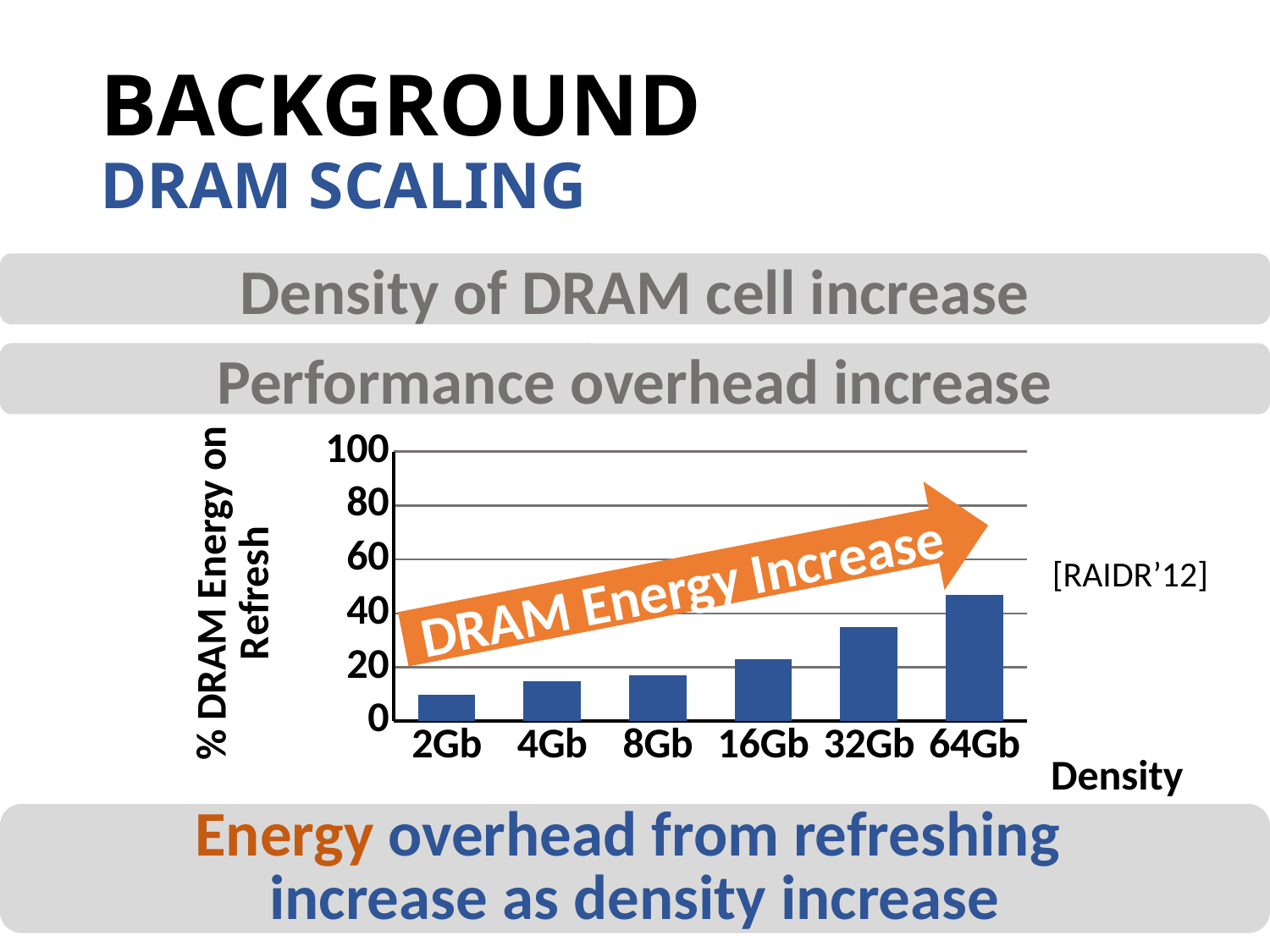
Is the value for 32Gb greater or less than 40? less Is the value for 64Gb greater or less than 40? greater Which density has the lowest % DRAM Energy on Refresh? 2Gb How many density categories are plotted on the x axis? 6 Do the values rise or fall as density increases along the x axis? rise Which density has the highest % DRAM Energy on Refresh? 64Gb What kind of chart is shown on the slide? bar chart Is the value for 2Gb greater or less than 20? less What text is written on the orange arrow over the chart? DRAM Energy Increase What is the label of the y axis? % DRAM Energy on Refresh Which has a larger % DRAM Energy on Refresh, 32Gb or 16Gb? 32Gb